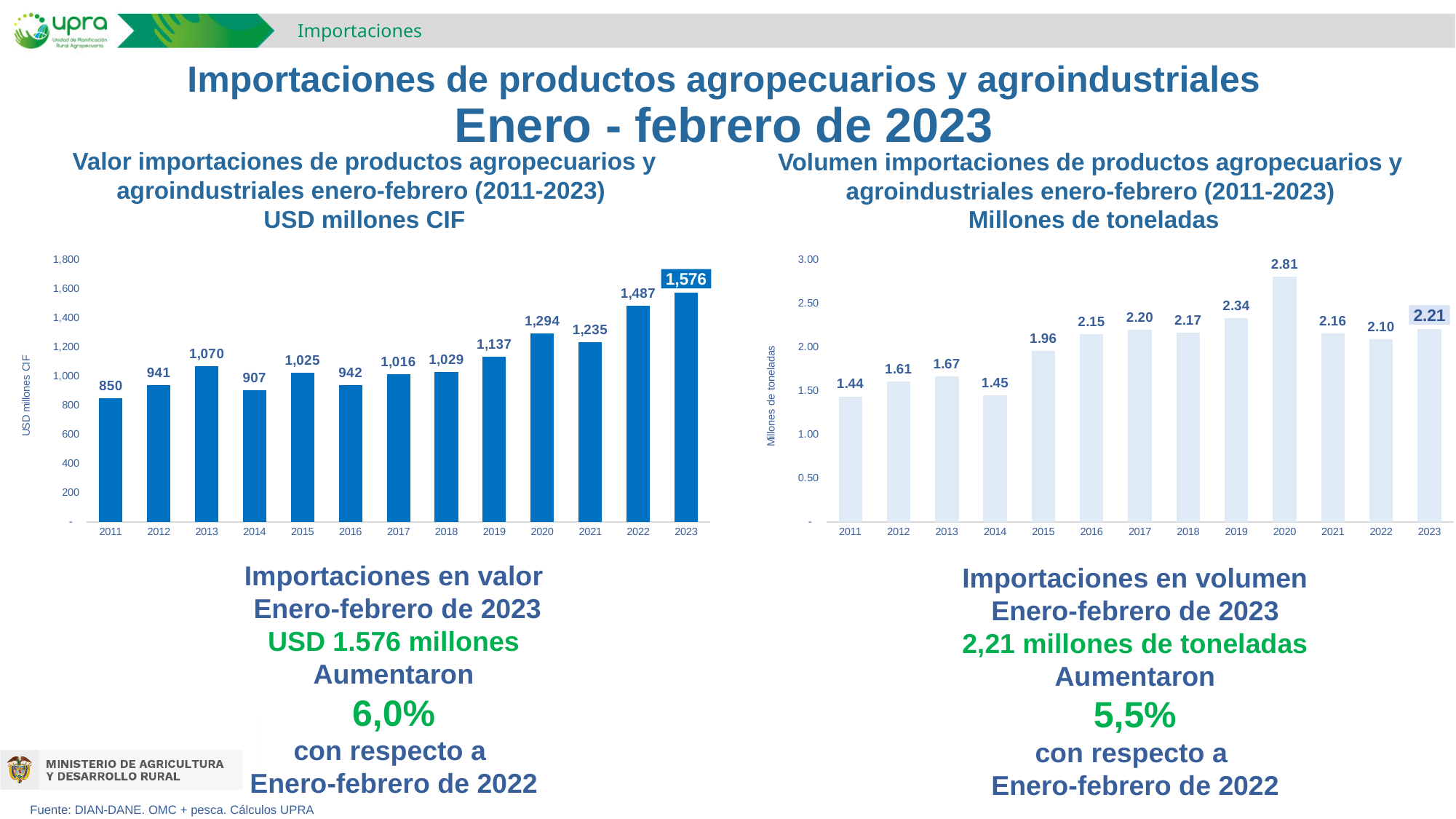
In the left chart (Valor importaciones, USD millones CIF), which is larger, the value for 2020 or the value for 2021? 2020 In the right chart (Volumen importaciones, Millones de toneladas), which year has the lowest value? 2011 In the left chart (Valor importaciones, USD millones CIF), what is the value for 2023? 1,576 In the left chart (Valor importaciones, USD millones CIF), how many years are plotted? 13 In the left chart (Valor importaciones, USD millones CIF), what is the difference between the 2023 and 2022 values? 89 In the right chart (Volumen importaciones, Millones de toneladas), what is the difference between the 2023 and 2022 values? 0.11 What is the y-axis label of the right chart (Volumen importaciones)? Millones de toneladas In the right chart (Volumen importaciones, Millones de toneladas), is the value for 2019 greater or less than 2.00? greater In the right chart (Volumen importaciones, Millones de toneladas), which year has the highest value? 2020 What kind of chart is the left chart (Valor importaciones, USD millones CIF)? Bar chart In the right chart (Volumen importaciones, Millones de toneladas), what is the value for 2020? 2.81 In the left chart (Valor importaciones, USD millones CIF), which year has the lowest value? 2011